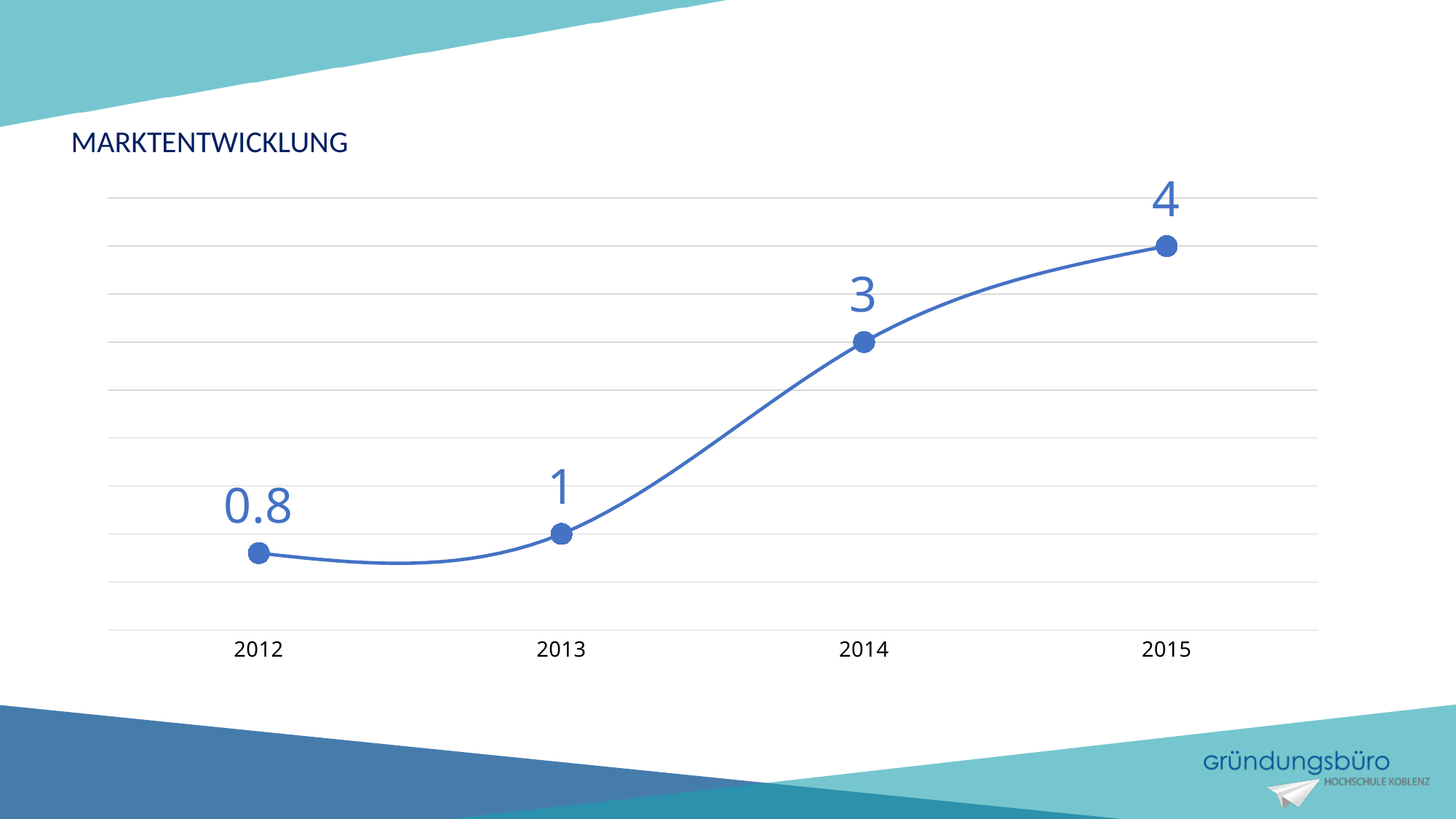
Do the values rise or fall from 2012 to 2015? rise What is the value for 2015? 4 What is the value for 2014? 3 Which year has the lowest value? 2012 How many data points are plotted on the chart? 4 What is the value for 2013? 1 What is the difference between the values for 2014 and 2013? 2 Which year has the highest value? 2015 What is the difference between the values for 2015 and 2012? 3.2 Which is larger, the value for 2014 or the value for 2013? 2014 What is the value for 2012? 0.8 What kind of chart is shown on the slide? line chart